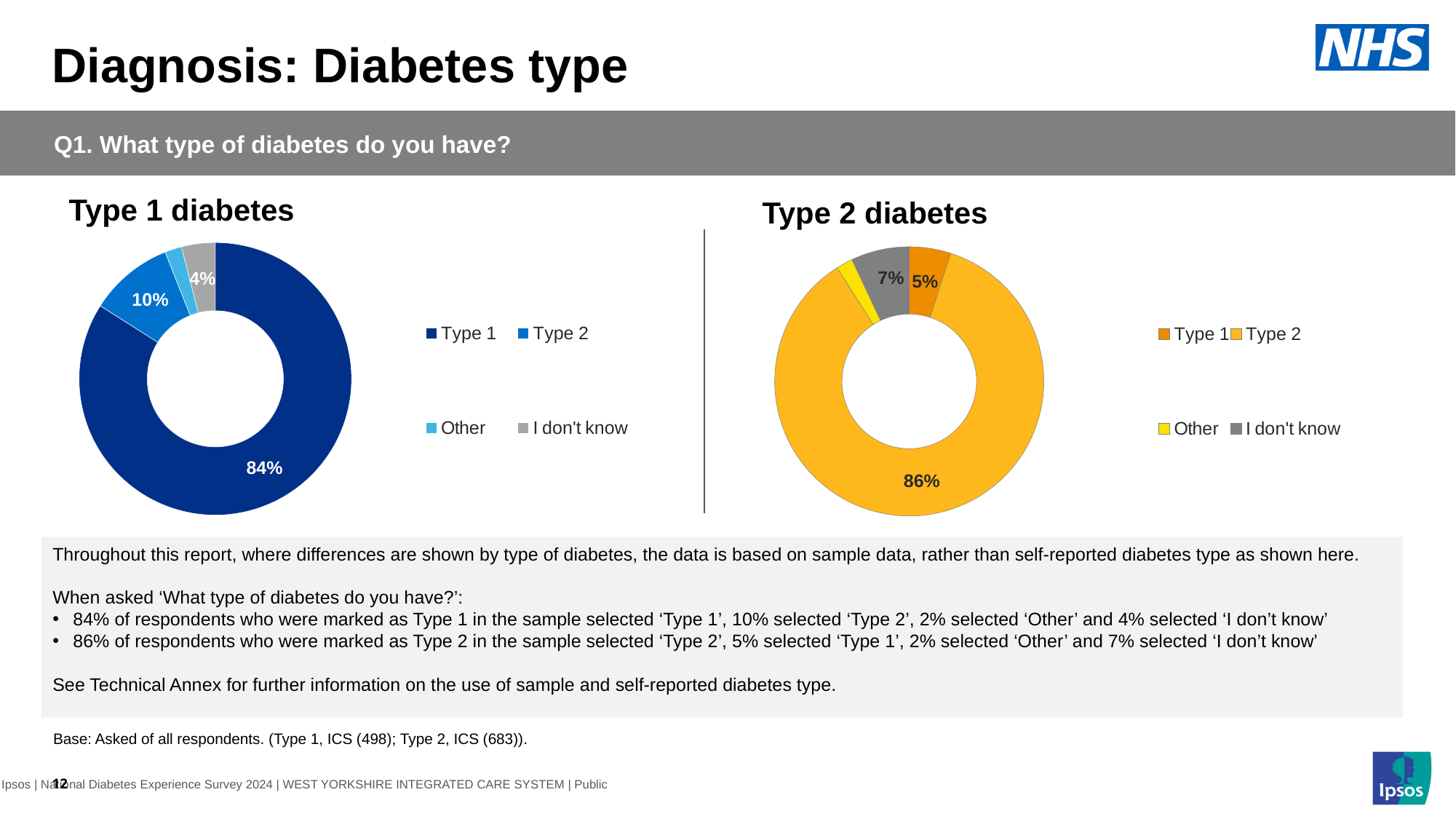
In the Type 1 diabetes chart, what percentage of respondents selected 'I don't know'? 4% In the Type 1 diabetes chart, what percentage of respondents selected 'Type 1'? 84% In the Type 1 diabetes chart, which category has the smallest share? Other In the Type 1 diabetes chart, what is the difference between the 'Type 1' share and the 'Type 2' share? 74 percentage points In the Type 2 diabetes chart, what percentage of respondents selected 'Type 1'? 5% In the Type 1 diabetes chart, what percentage of respondents selected 'Type 2'? 10% In the Type 2 diabetes chart, which category has the largest share? Type 2 What kind of chart is used for the Type 2 diabetes data? Donut (pie) chart In the Type 2 diabetes chart, which is larger: the 'I don't know' share or the 'Type 1' share? I don't know In the Type 2 diabetes chart, what percentage of respondents selected 'Type 2'? 86% In the Type 2 diabetes chart, what percentage of respondents selected 'I don't know'? 7% How many categories does the legend of the Type 1 diabetes chart list? 4